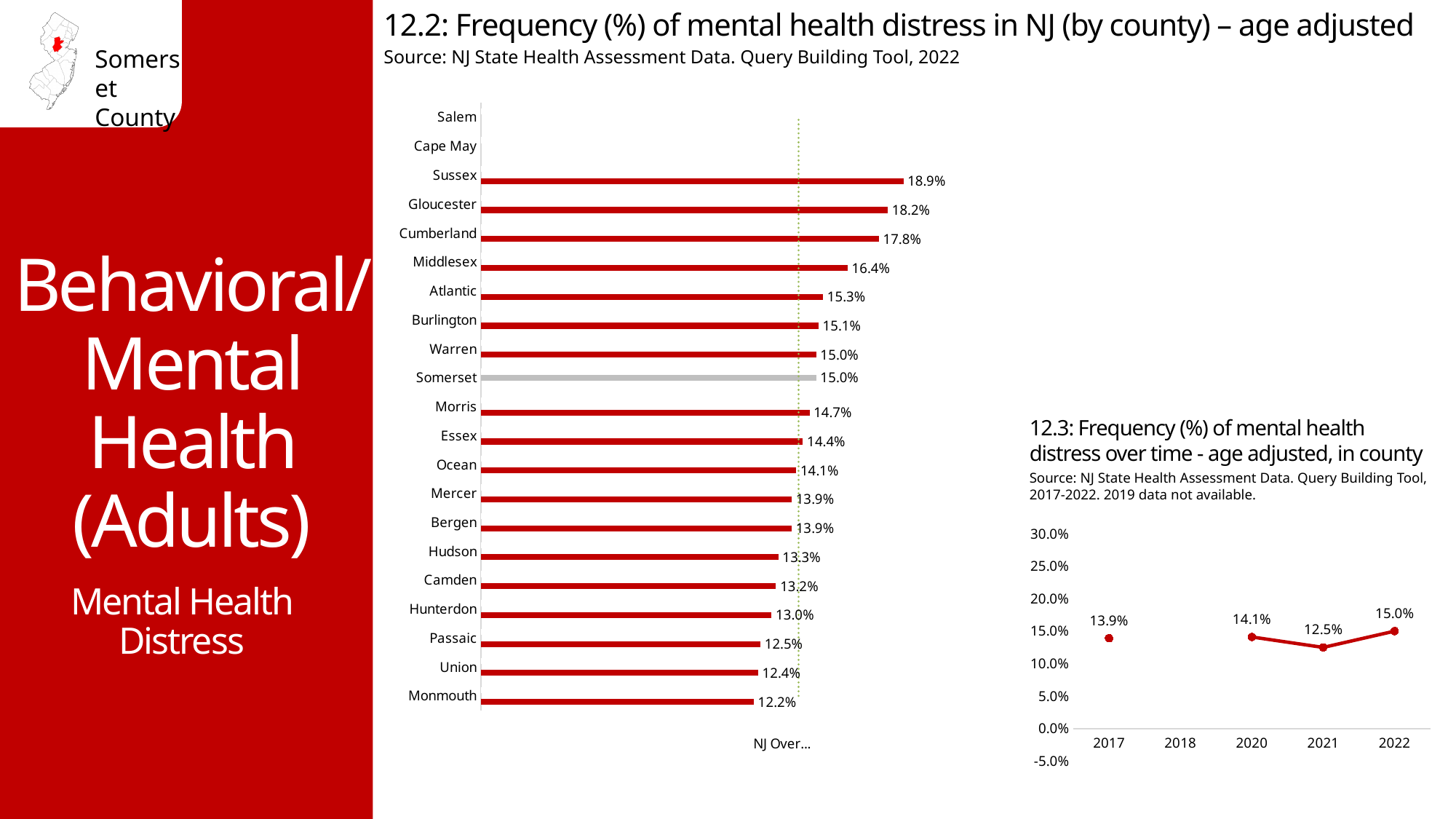
In chart 12.3, which year has the highest value? 2022 In chart 12.2, what is the frequency of mental health distress for Sussex county? 18.9% In chart 12.2, how many counties have a bar with a value plotted? 19 In chart 12.2, which county has the highest frequency of mental health distress? Sussex In chart 12.2, what is the value shown for Somerset county? 15.0% In chart 12.3, what was the frequency of mental health distress in 2021? 12.5% In chart 12.2, what is the difference between the values for Gloucester and Monmouth? 6.0% In chart 12.2, which county with a plotted bar has the lowest frequency of mental health distress? Monmouth In chart 12.3, how many data points are plotted? 4 In chart 12.2, what kind of chart is used to show the county values? Bar chart In chart 12.2, which county has a higher value, Middlesex or Atlantic? Middlesex In chart 12.3, what is the difference between the 2022 and 2021 values? 2.5%